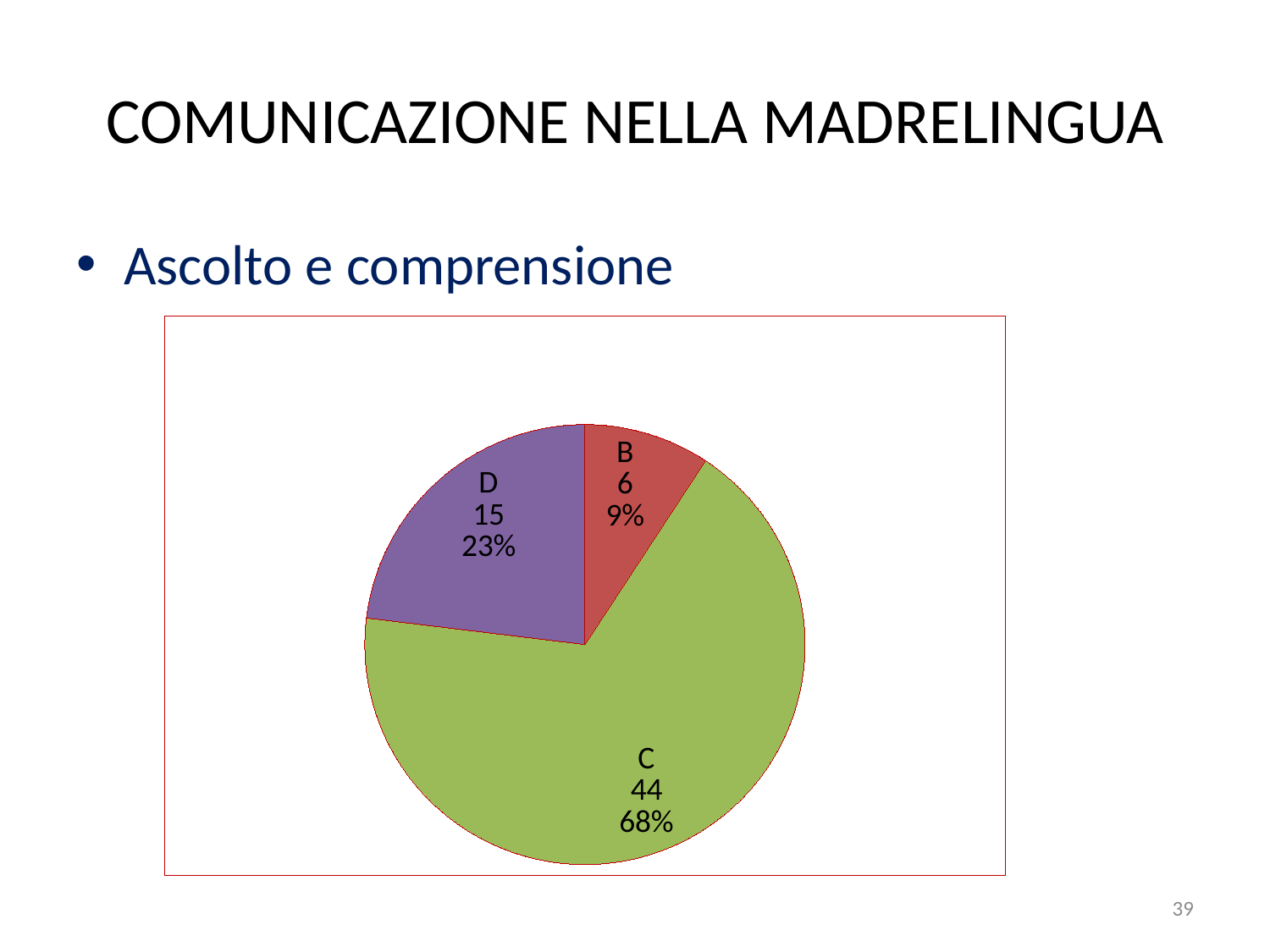
Which is larger, the value for D or the value for B? D What is the difference between the values for C and D? 29 What share of the pie does slice B represent? 9% What kind of chart is shown on the slide? pie chart What is the value for slice C? 44 How many slices does the pie chart have? 3 Which slice is the smallest? B What is the value for slice B? 6 What share of the pie does slice C represent? 68% Which slice is the largest? C What is the value for slice D? 15 What share of the pie does slice D represent? 23%